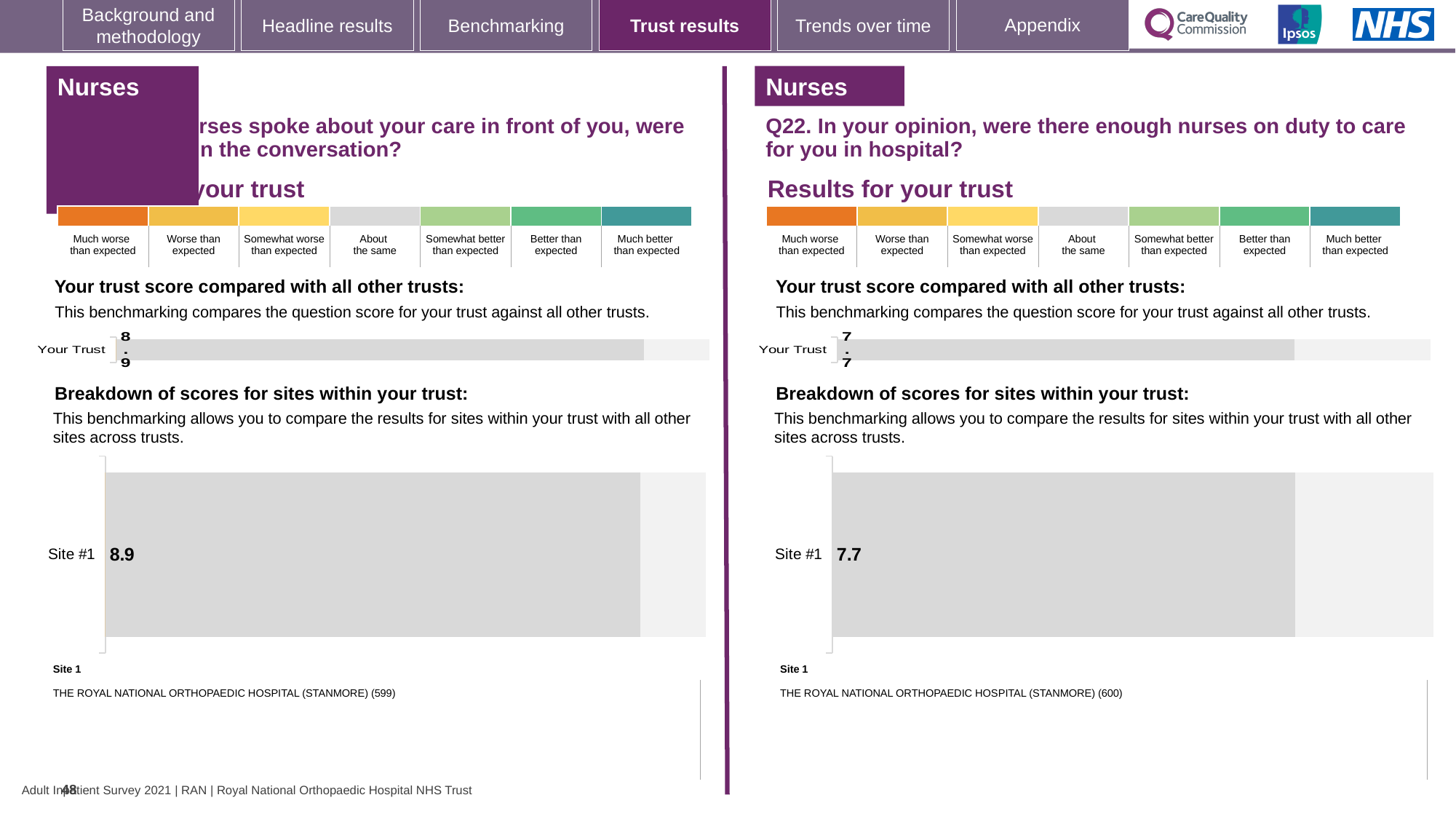
On the left half of the slide, what is the value shown for Your Trust in the trust score comparison chart? 8.9 On the left half of the slide, what is the score shown for Site #1 in the breakdown of scores for sites within your trust? 8.9 How many sites are shown in the breakdown of scores chart on the left half of the slide? 1 What kind of chart is used to show the Site #1 score on the right half of the slide (Q22)? Bar chart What is the difference between the Site #1 score on the left half of the slide and the Site #1 score on the right half (Q22)? 1.2 How many sites are shown in the breakdown of scores chart on the right half of the slide (Q22)? 1 On the left half of the slide, what is the number in brackets after the Site 1 name below the breakdown chart? 599 On the right half of the slide (Q22), which site is listed as Site 1 below the breakdown chart? THE ROYAL NATIONAL ORTHOPAEDIC HOSPITAL (STANMORE) (600) On the right half of the slide (Q22), what is the score shown for Site #1 in the breakdown of scores for sites within your trust? 7.7 On the right half of the slide (Q22), what is the value shown for Your Trust in the trust score comparison chart? 7.7 Which Site #1 score is larger: the one on the left half of the slide or the one on the right half (Q22)? The left half (8.9)